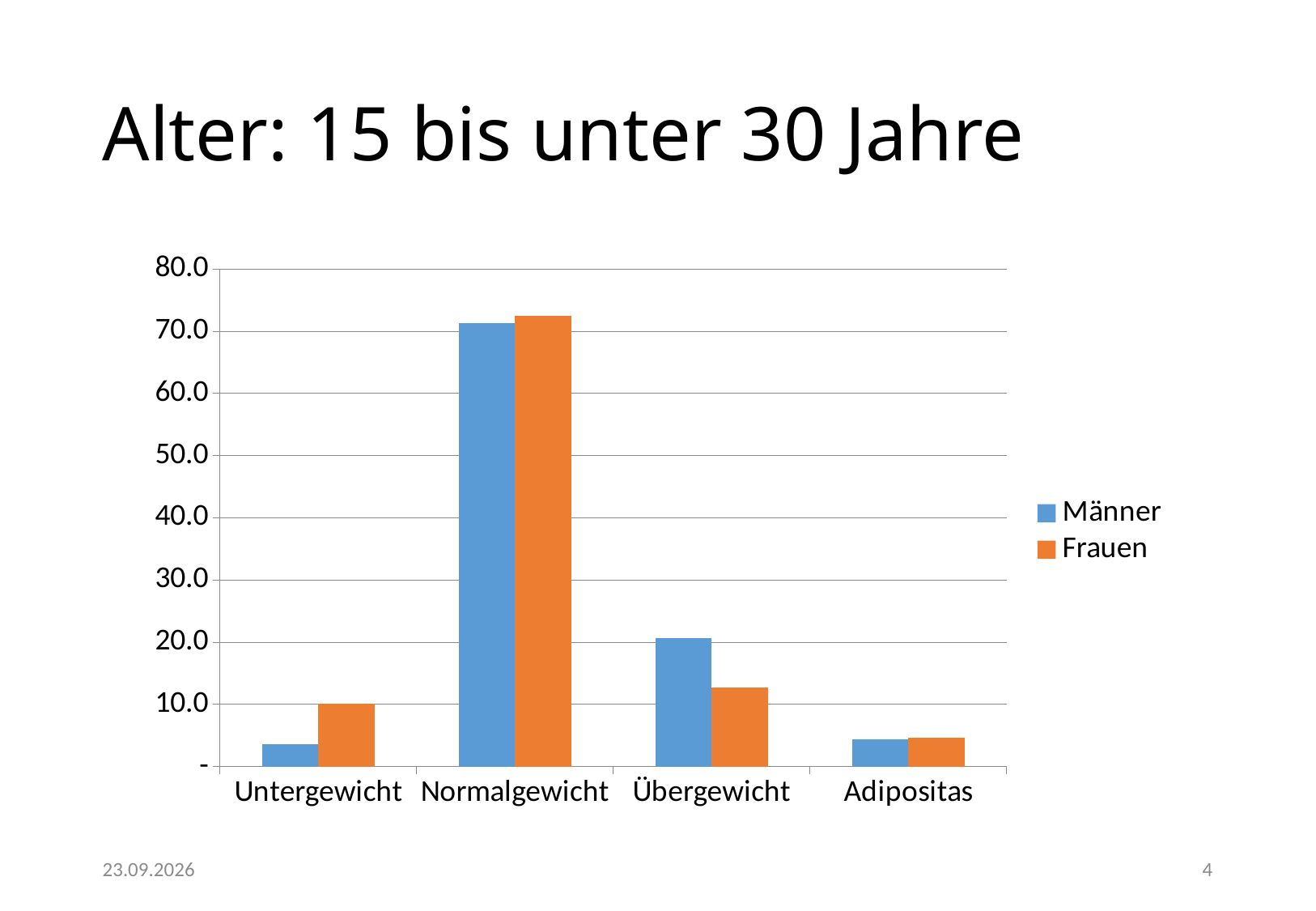
What kind of chart is shown on the slide? bar chart Is the value for Männer in Normalgewicht greater or less than 60.0? greater For Untergewicht, which series has the larger value, Männer or Frauen? Frauen Is the value for Männer in Adipositas greater or less than 10.0? less How many categories are shown on the x axis? 4 How many series does the legend list? 2 Which category has the highest value for Frauen? Normalgewicht Which category has the highest value for Männer? Normalgewicht Which category has the lowest value for Männer? Untergewicht Is the value for Frauen in Übergewicht greater or less than 20.0? less What is the title of the slide containing the chart? Alter: 15 bis unter 30 Jahre For Übergewicht, which series has the larger value, Männer or Frauen? Männer